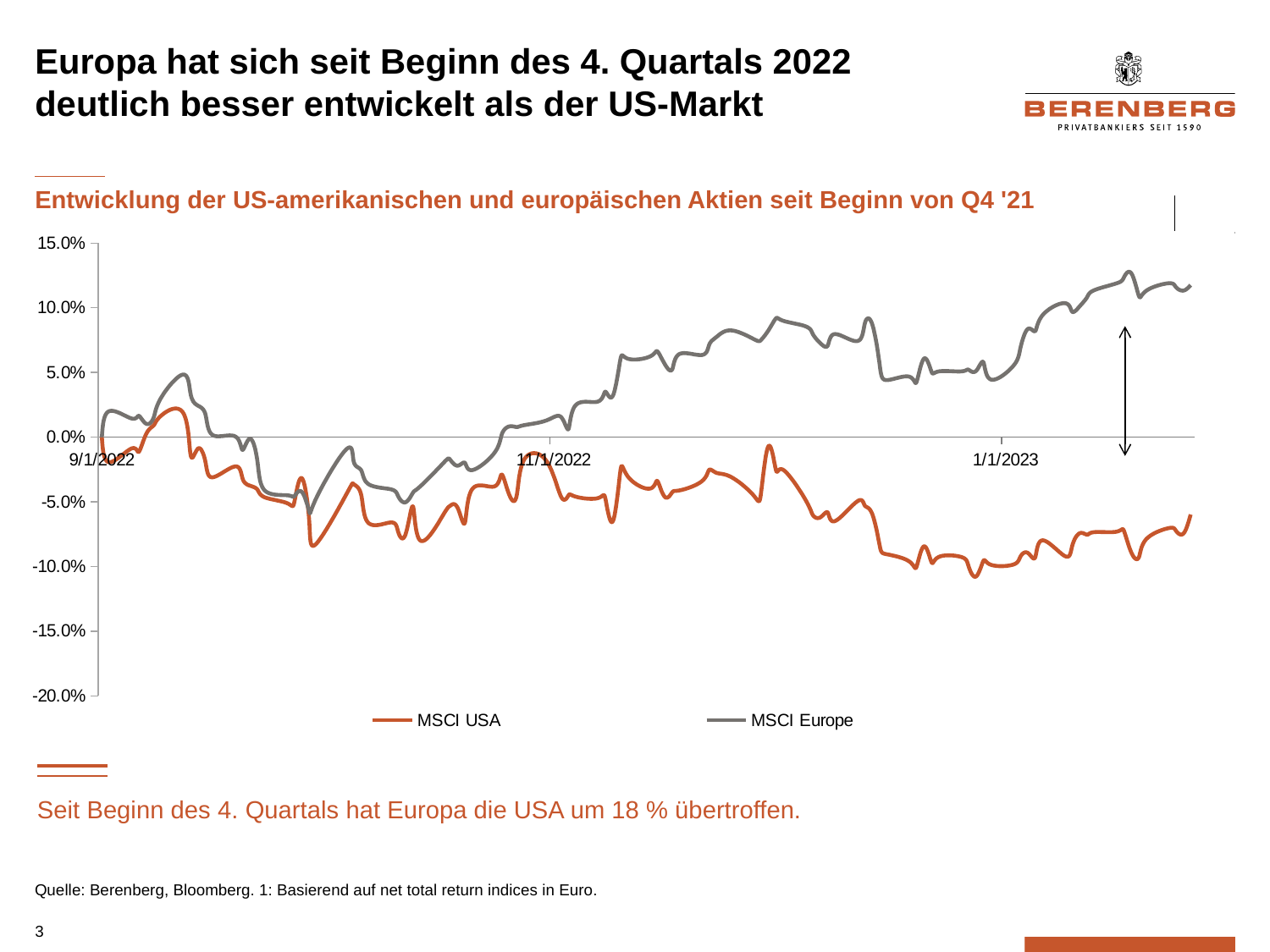
At 1/1/2023, which series has the higher value, MSCI USA or MSCI Europe? MSCI Europe At the right end of the chart, which series is higher, MSCI USA or MSCI Europe? MSCI Europe What kind of chart is shown on the slide? line chart Is the value for MSCI Europe at 1/1/2023 greater or less than 0.0%? greater How many series does the chart legend list? 2 Does the MSCI Europe line overall rise or fall between 11/1/2022 and the right end of the chart? rise Which colour is used for the MSCI USA line? orange How many date labels are shown on the x axis? 3 Is the value for MSCI USA at 1/1/2023 greater or less than -5.0%? less Is the value for MSCI Europe at the right end of the chart greater or less than 10.0%? greater What are the two series named in the chart legend? MSCI USA and MSCI Europe